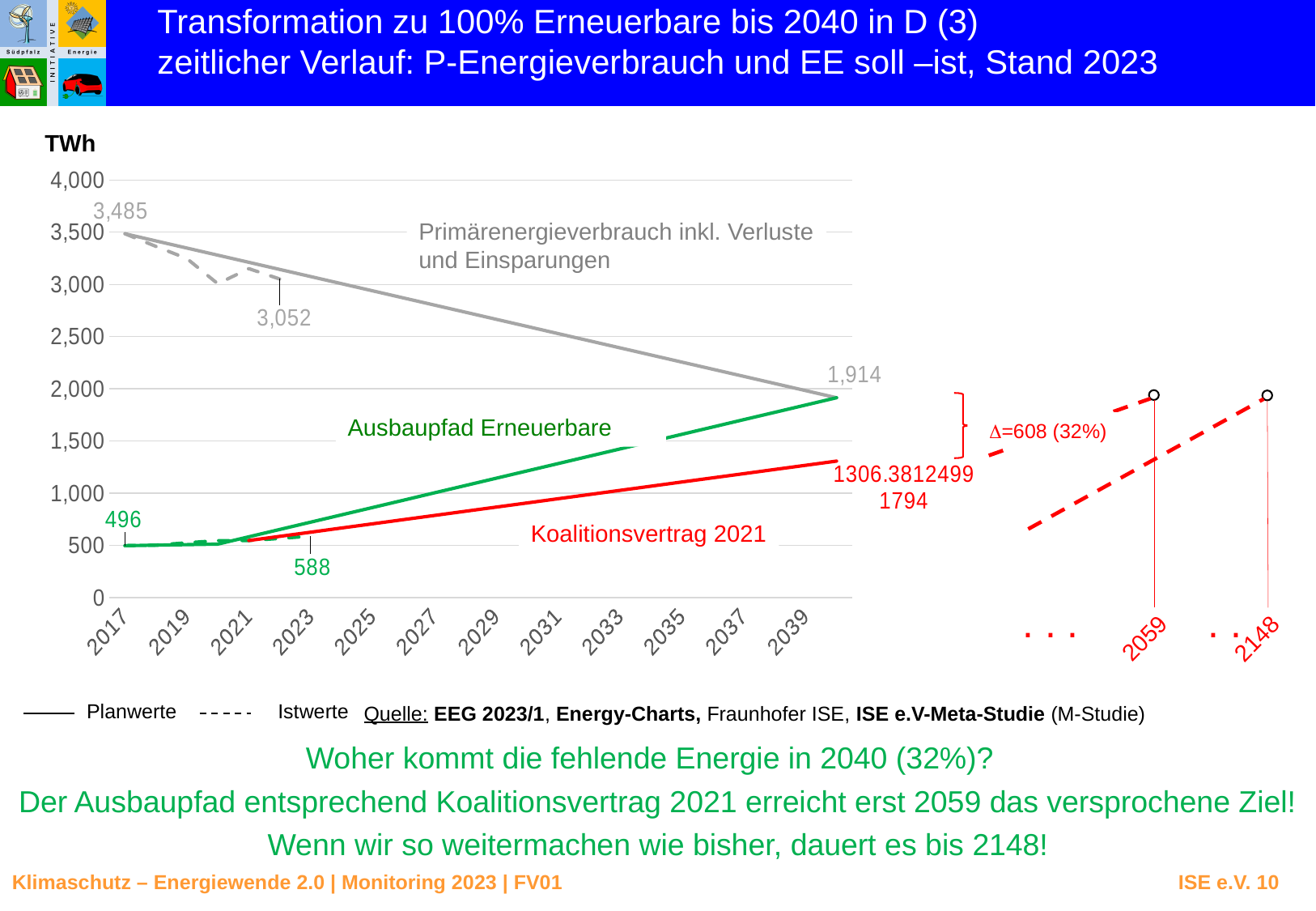
By how much did the Primärenergieverbrauch fall from 3,485 in 2017 to the 2023 Istwert of 3,052? 433 What is the labelled Istwert of Primärenergieverbrauch in 2023? 3,052 What is the value of Primärenergieverbrauch inkl. Verluste und Einsparungen in 2017? 3,485 What is the difference between the Erneuerbare Istwert in 2023 (588) and the 2017 value (496)? 92 What value is labelled at the end of the Primärenergieverbrauch line around 2040? 1,914 What is the value of the Ausbaupfad Erneuerbare in 2017? 496 What unit is shown above the y axis of the chart? TWh What kind of chart is shown on the slide? line chart Is the value of the Koalitionsvertrag 2021 line at the right end of the chart greater or less than 1,500? less What is the labelled Istwert of the Erneuerbare in 2023? 588 At the right end of the chart (2039), which line is higher: Ausbaupfad Erneuerbare or Koalitionsvertrag 2021? Ausbaupfad Erneuerbare Does the Primärenergieverbrauch line rise or fall from 2017 to 2039? fall